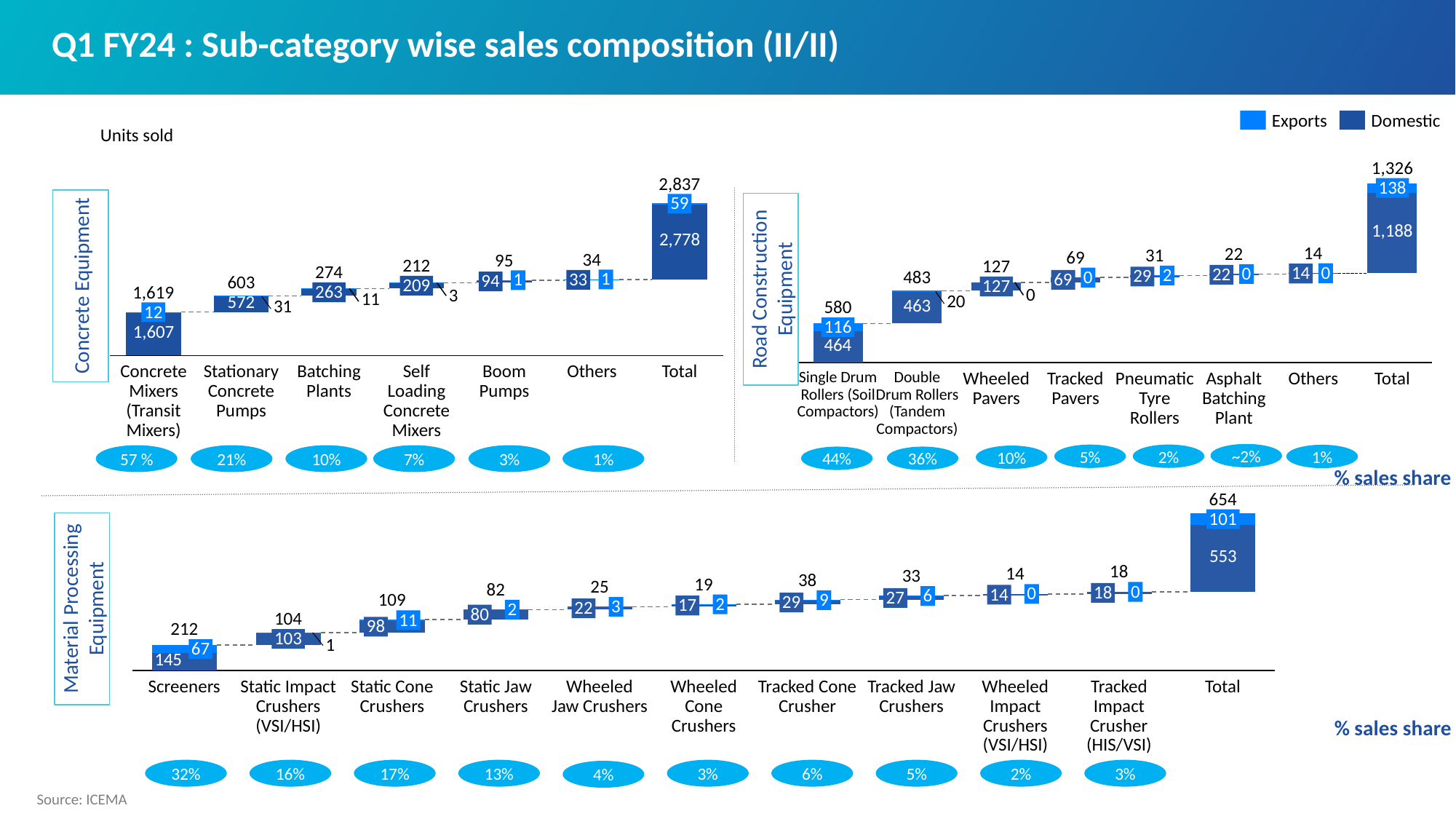
In the Road Construction Equipment chart, what is the % sales share of Wheeled Pavers? 10% In the Concrete Equipment chart, what is the total number of units sold for Concrete Mixers (Transit Mixers)? 1,619 In the Road Construction Equipment chart, what is the difference in total units sold between Single Drum Rollers (Soil Compactors) and Double Drum Rollers (Tandem Compactors)? 97 In the Concrete Equipment chart, which sub-category has the lowest units sold? Others In the Material Processing Equipment chart, which sub-category has the highest units sold (excluding Total)? Screeners How many series does the legend list? 2 In the Road Construction Equipment chart, how many Exports units of Single Drum Rollers (Soil Compactors) were sold? 116 In the Concrete Equipment chart, how many Domestic units of Stationary Concrete Pumps were sold? 572 In the Material Processing Equipment chart, how many Exports units of Screeners were sold? 67 In the Concrete Equipment chart, what is the Total bar's overall value? 2,837 In the Material Processing Equipment chart, which is larger: units sold for Static Cone Crushers or Static Jaw Crushers? Static Cone Crushers What type of chart is used for the Material Processing Equipment data? Stacked bar chart